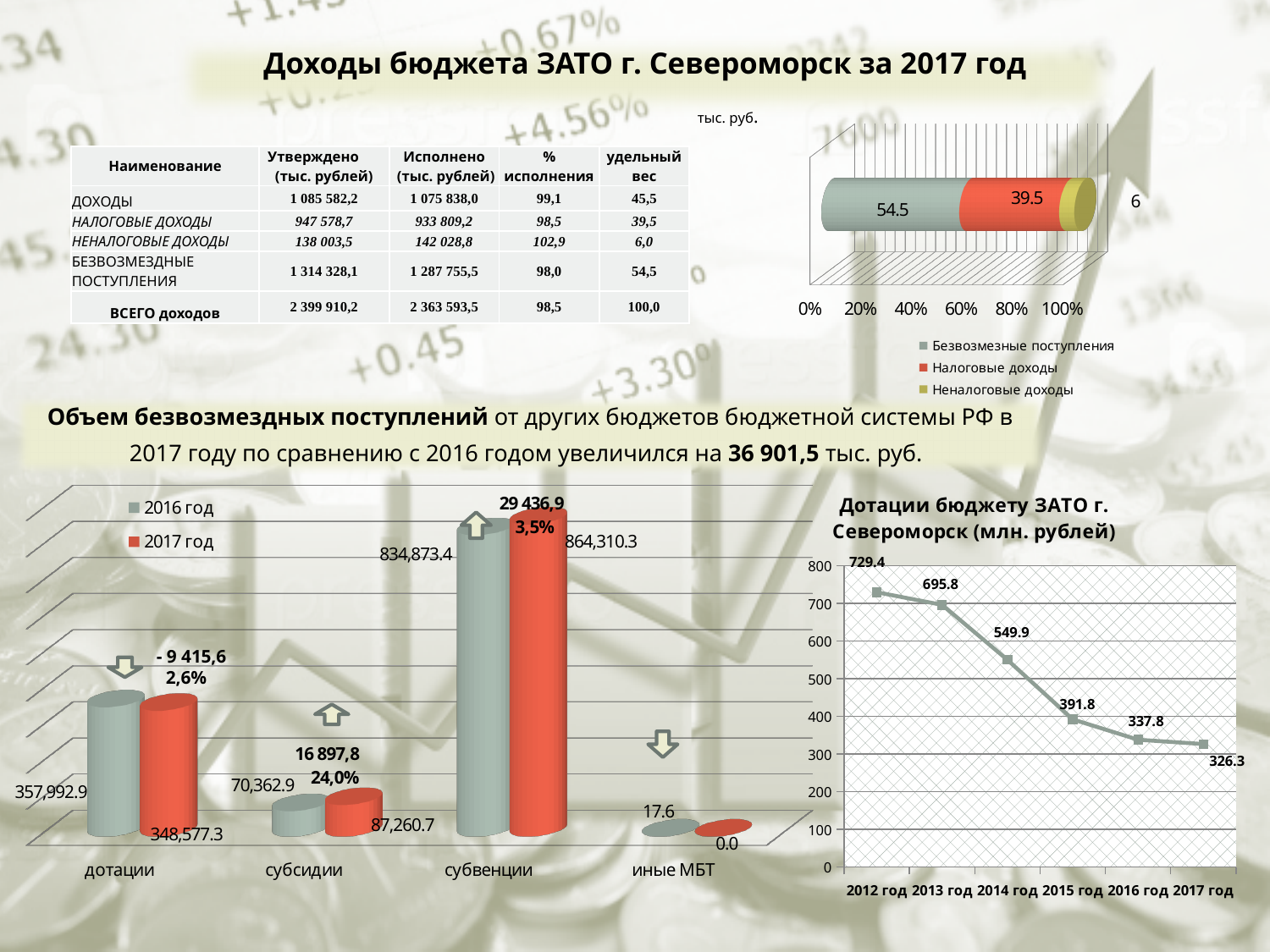
In the bottom-left bar chart comparing 2016 год and 2017 год, what is the 2017 год value for субсидии? 87,260.7 In the line chart titled 'Дотации бюджету ЗАТО г. Североморск (млн. рублей)', which year has the lowest value? 2017 год In the top-right stacked bar chart, what is the value for Безвозмездные поступления? 54.5 In the line chart titled 'Дотации бюджету ЗАТО г. Североморск (млн. рублей)', what is the value for 2012 год? 729.4 How many data points are plotted in the line chart titled 'Дотации бюджету ЗАТО г. Североморск (млн. рублей)'? 6 In the line chart titled 'Дотации бюджету ЗАТО г. Североморск (млн. рублей)', what is the value for 2017 год? 326.3 In the bottom-left bar chart comparing 2016 год and 2017 год, which category has the highest values? субвенции In the line chart titled 'Дотации бюджету ЗАТО г. Североморск (млн. рублей)', do the values rise or fall from 2012 to 2017? fall How many series does the legend of the bottom-left bar chart list? 2 What type of chart is the top-right chart showing Безвозмездные поступления, Налоговые доходы and Неналоговые доходы? bar chart In the line chart titled 'Дотации бюджету ЗАТО г. Североморск (млн. рублей)', what is the difference between the 2014 год and 2015 год values? 158.1 In the bottom-left bar chart comparing 2016 год and 2017 год, what is the 2016 год value for дотации? 357,992.9